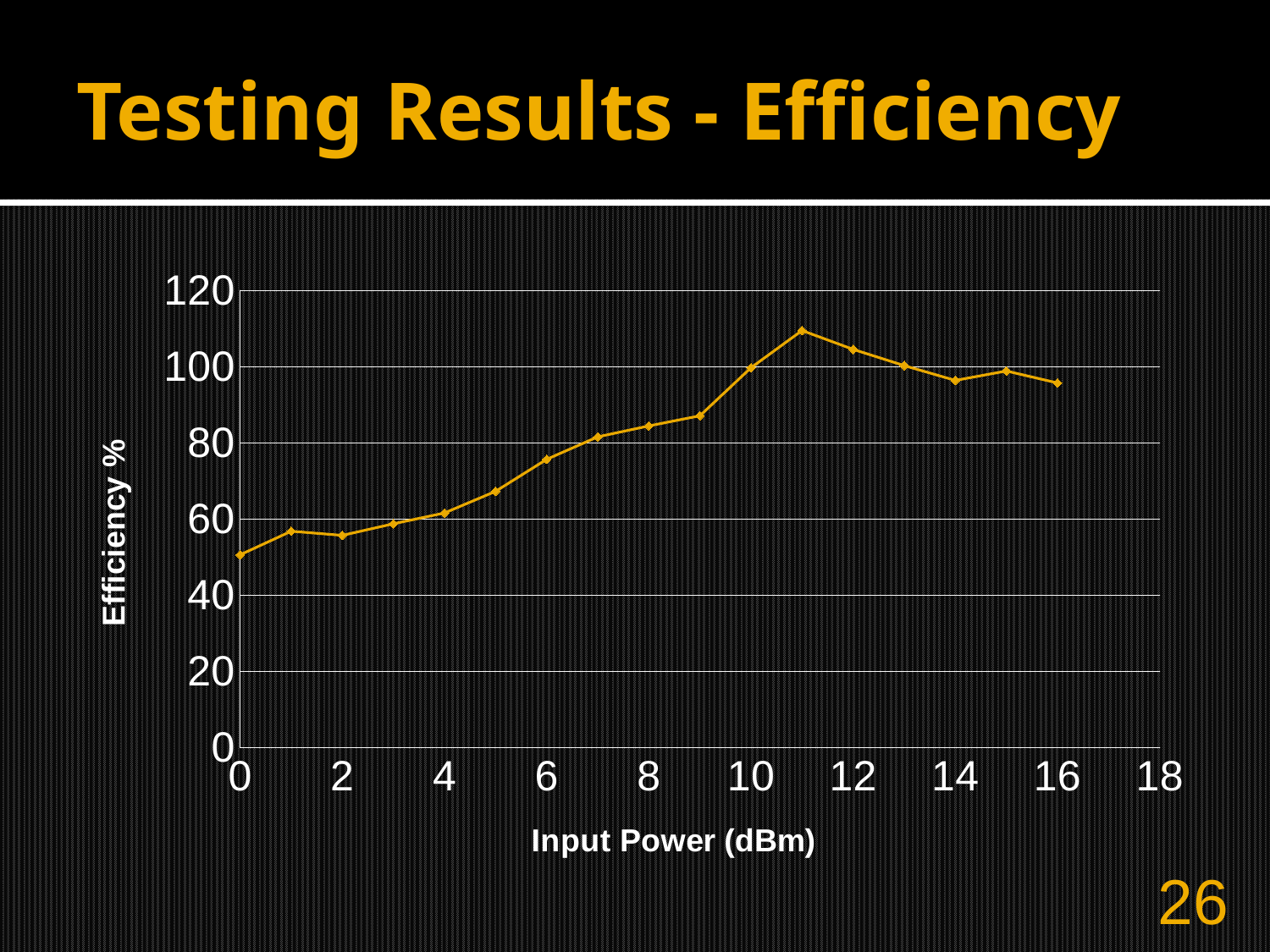
At which input power (dBm) is the efficiency highest? 11 At which input power (dBm) is the efficiency lowest? 0 Is the efficiency at an input power of 16 dBm greater or less than 100? less What is the label of the x axis? Input Power (dBm) Is the efficiency at an input power of 11 dBm greater or less than 100? greater Is the efficiency at an input power of 0 dBm greater or less than 60? less How many data points are plotted on the line? 17 Which has the higher efficiency: an input power of 10 dBm or 5 dBm? 10 dBm What is the label of the y axis? Efficiency % Does the efficiency generally rise or fall as input power increases from 0 to 11 dBm? rise What kind of chart is shown on the slide? line chart